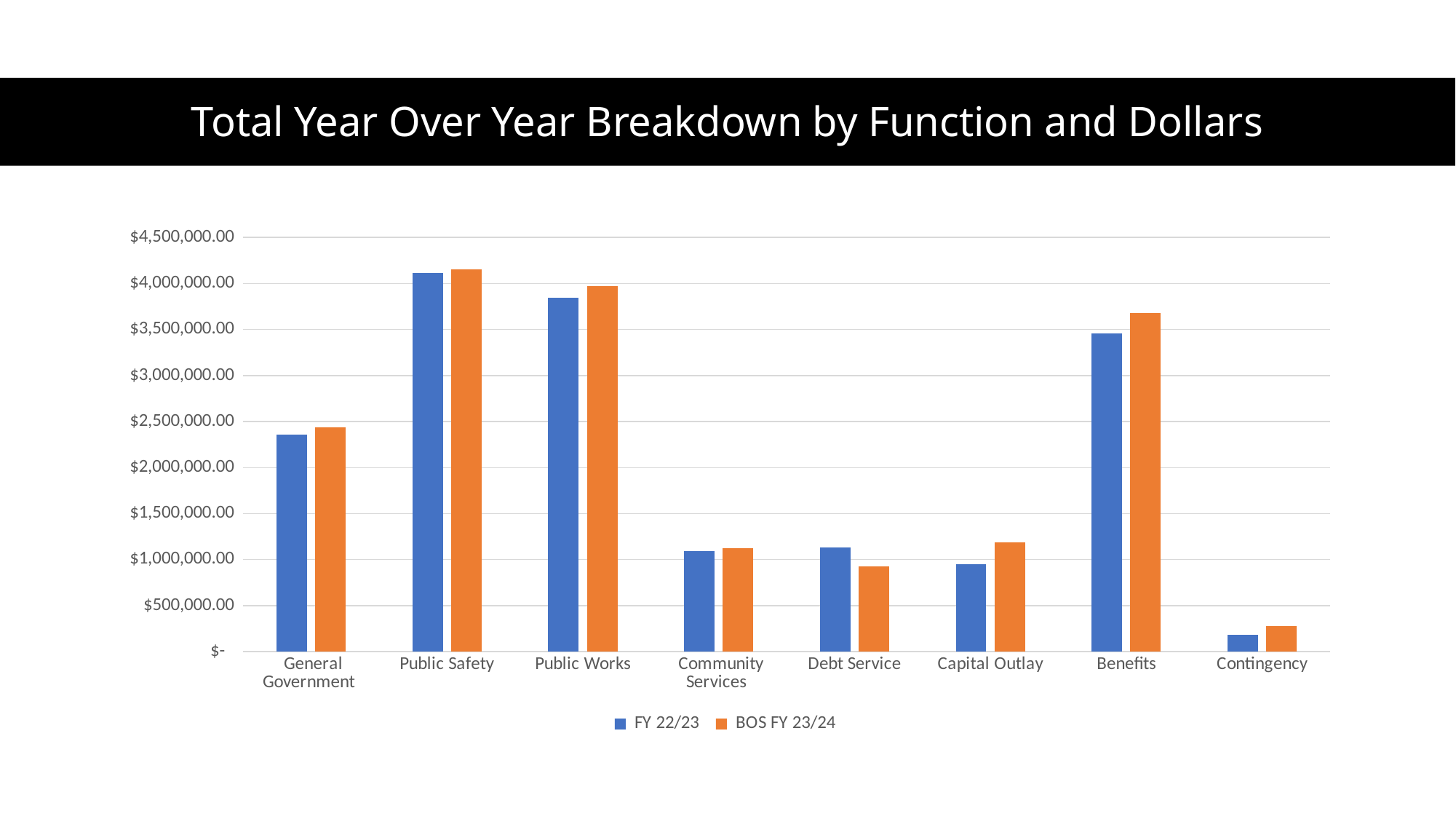
What type of chart is shown on the slide? bar chart Is the BOS FY 23/24 value for Contingency greater or less than $500,000.00? less For Capital Outlay, which is larger: FY 22/23 or BOS FY 23/24? BOS FY 23/24 How many function categories are shown on the x axis? 8 Is the FY 22/23 value for Public Safety greater or less than $4,000,000.00? greater Is the BOS FY 23/24 value for Debt Service greater or less than $1,000,000.00? less Which function has the highest FY 22/23 value? Public Safety Which function has the lowest BOS FY 23/24 value? Contingency How many series does the legend list? 2 For Debt Service, which is larger: FY 22/23 or BOS FY 23/24? FY 22/23 What is the title of the chart? Total Year Over Year Breakdown by Function and Dollars